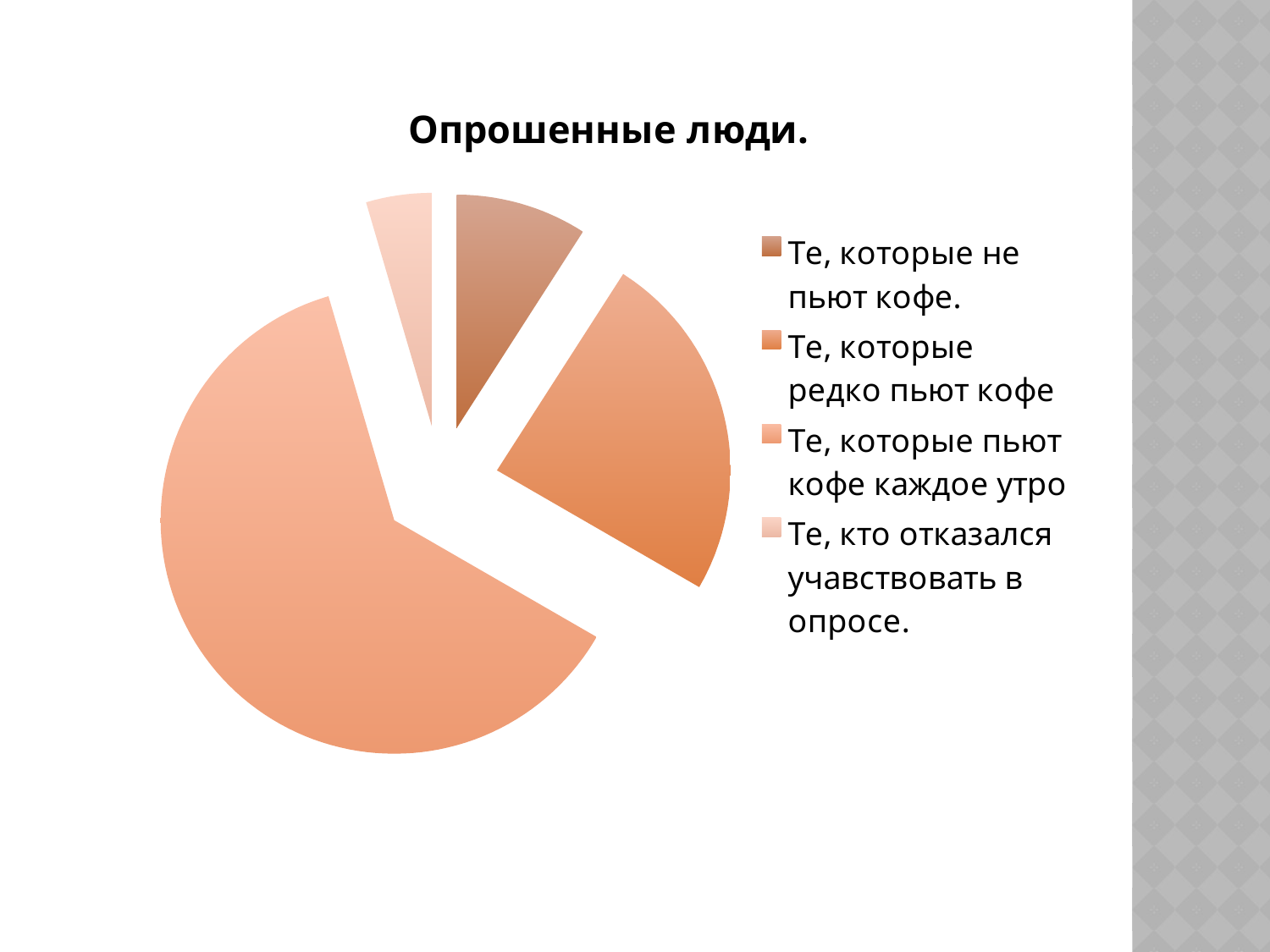
What is the title of the chart? Опрошенные люди. How many entries does the legend list? 4 Which slice is larger: "Те, которые не пьют кофе." or "Те, кто отказался учавствовать в опросе."? Те, которые не пьют кофе. What kind of chart is shown on the slide? Pie chart Which category has the smallest slice of the pie? Те, кто отказался учавствовать в опросе. Which slice is larger: "Те, которые редко пьют кофе" or "Те, которые не пьют кофе."? Те, которые редко пьют кофе How many slices does the pie chart have? 4 Which legend entry is listed first? Те, которые не пьют кофе. Which category has the largest slice of the pie? Те, которые пьют кофе каждое утро Which slice is larger: "Те, которые пьют кофе каждое утро" or "Те, которые редко пьют кофе"? Те, которые пьют кофе каждое утро